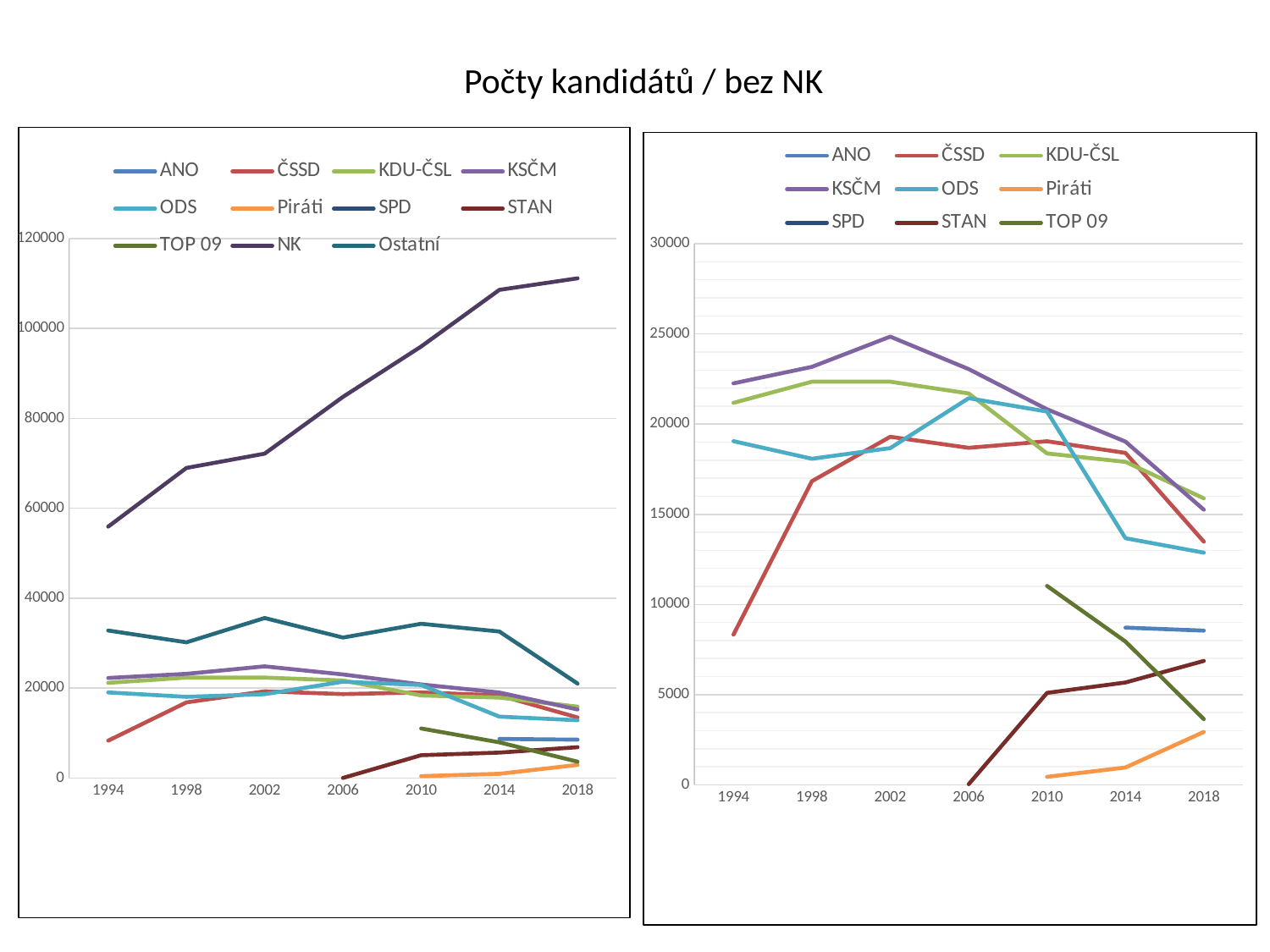
What type of chart is the right-hand chart on the slide? line chart In the left-hand chart, is the value for NK in 2018 greater or less than 100000? greater How many series does the legend of the right-hand chart list? 9 How many years are shown on the x axis of the right-hand chart? 7 In the right-hand chart, is the value for ČSSD in 1994 greater or less than 10000? less In the right-hand chart, which series has the highest value in 1994? KSČM In the right-hand chart, does the TOP 09 series rise or fall from 2010 to 2018? fall In the right-hand chart, which series has the lowest value in 2018? Piráti In the left-hand chart, which series has the highest values across all years? NK How many series does the legend of the left-hand chart list? 11 In the left-hand chart, is the value for Ostatní in 2018 greater or less than 40000? less In the left-hand chart, does the NK series rise or fall from 1994 to 2018? rise